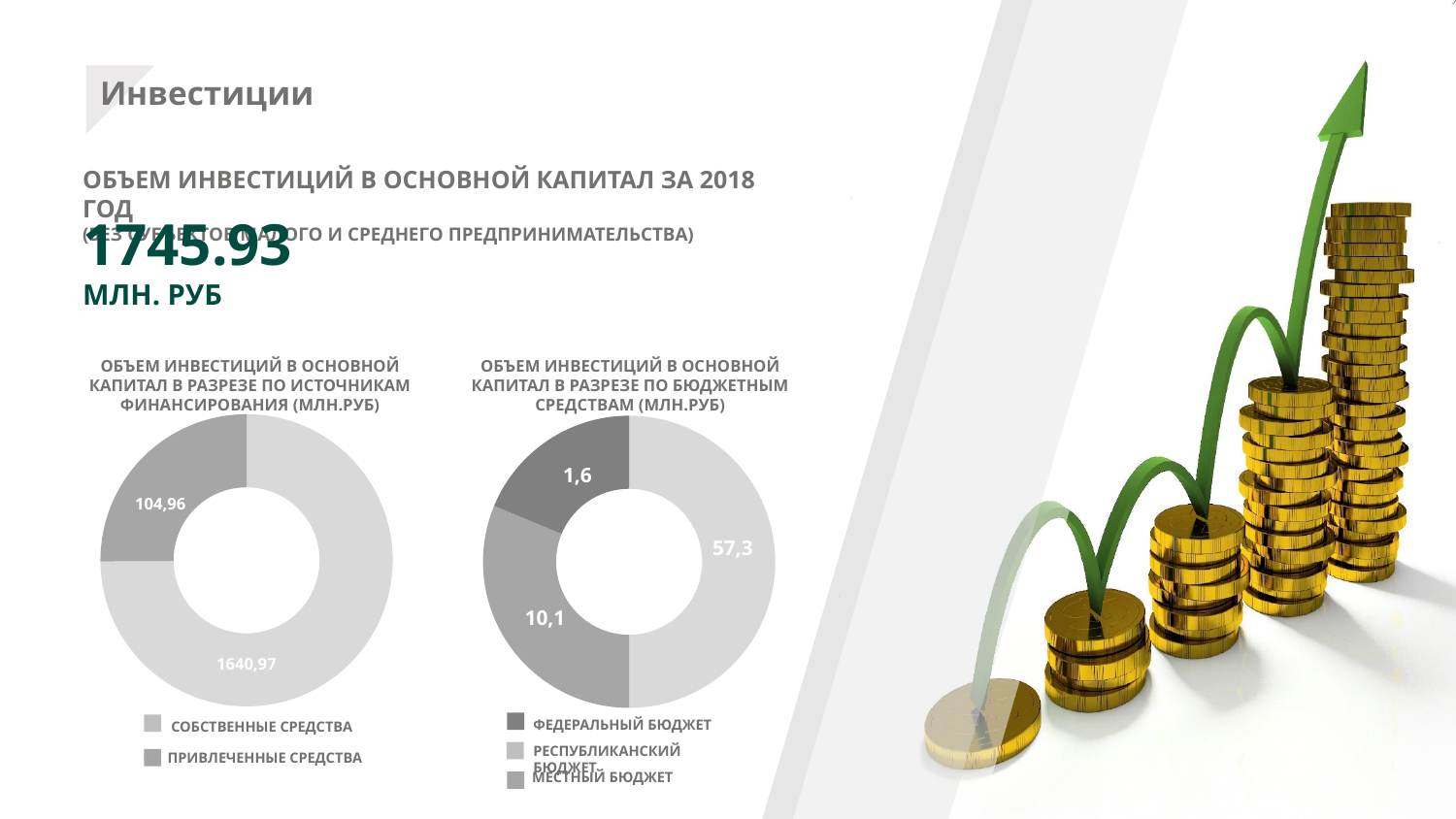
How many entries does the legend of the right chart (по бюджетным средствам) list? 3 In the right chart (по бюджетным средствам), which budget source has the smallest slice? Федеральный бюджет In the left chart (по источникам финансирования), what is the total of the two slices? 1745,93 In the right chart (по бюджетным средствам), what is the value for Федеральный бюджет? 1,6 In the left chart (по источникам финансирования), what is the value of the smaller slice? 104,96 In the left chart (по источникам финансирования), what is the difference between the two slice values, 1640,97 and 104,96? 1536,01 What kind of chart is the left chart, 'Объем инвестиций в основной капитал в разрезе по источникам финансирования'? Donut (pie) chart How many slices does the left chart (по источникам финансирования) have? 2 In the right chart (по бюджетным средствам), what is the difference between Республиканский бюджет (57,3) and Местный бюджет (10,1)? 47,2 In the right chart (по бюджетным средствам), what is the value for Республиканский бюджет? 57,3 In the right chart (по бюджетным средствам), which budget source has the largest slice? Республиканский бюджет In the left chart (по источникам финансирования), what is the value of the larger slice? 1640,97